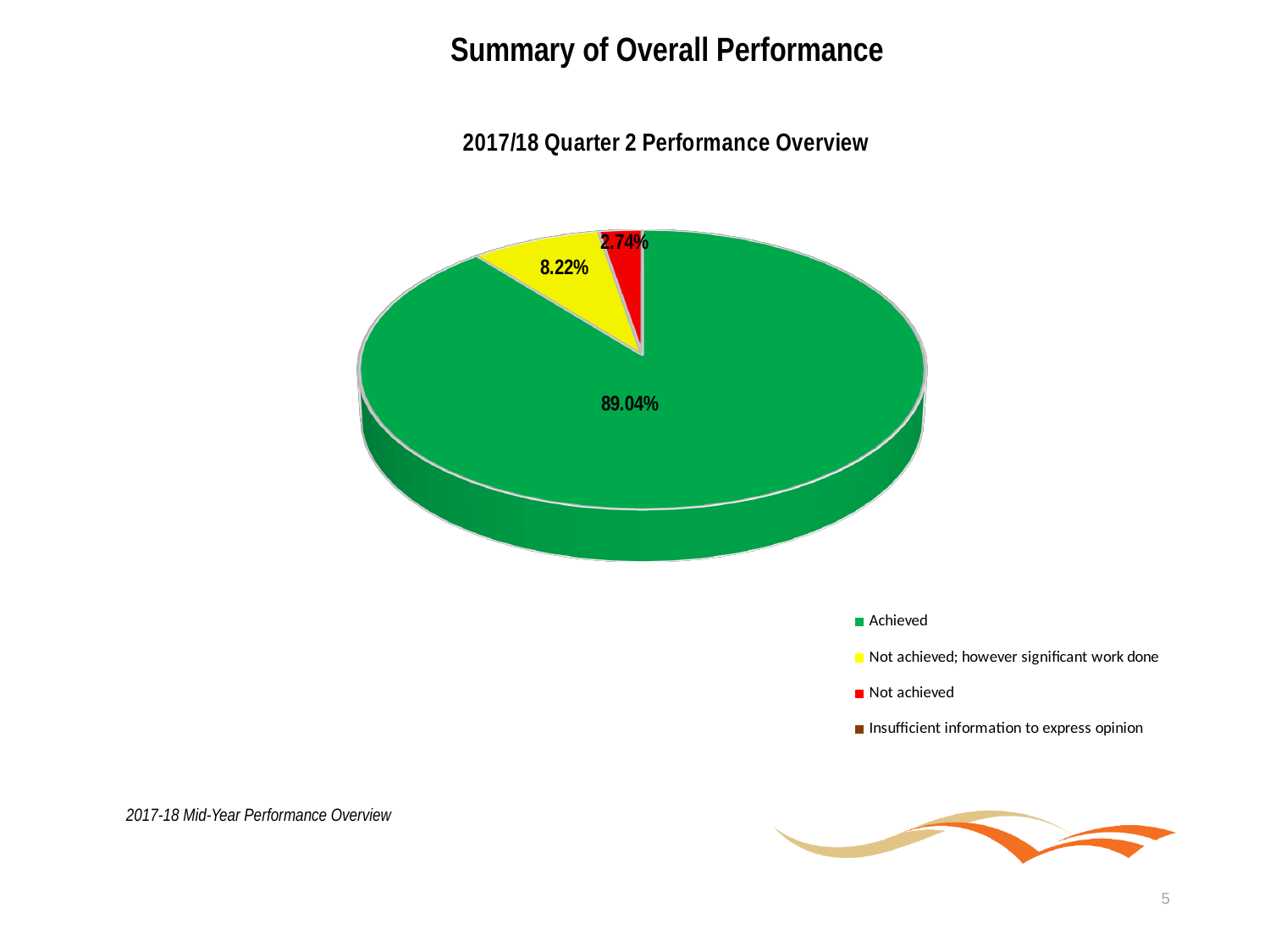
Which category has the largest share of the pie? Achieved How many entries does the legend list? 4 What is the difference in percentage points between the Achieved slice and the 'Not achieved; however significant work done' slice? 80.82% What is the title of the chart? 2017/18 Quarter 2 Performance Overview What percentage is shown for the 'Not achieved' slice? 2.74% What colour is the Achieved slice? green How many slices with data labels are visible in the pie? 3 Which labelled slice has the smallest share of the pie? Not achieved Which is larger: the 'Not achieved; however significant work done' slice or the 'Not achieved' slice? Not achieved; however significant work done What percentage of the pie is labelled for the Achieved category? 89.04% What percentage is shown for the 'Not achieved; however significant work done' slice? 8.22% What type of chart is shown on the slide? pie chart